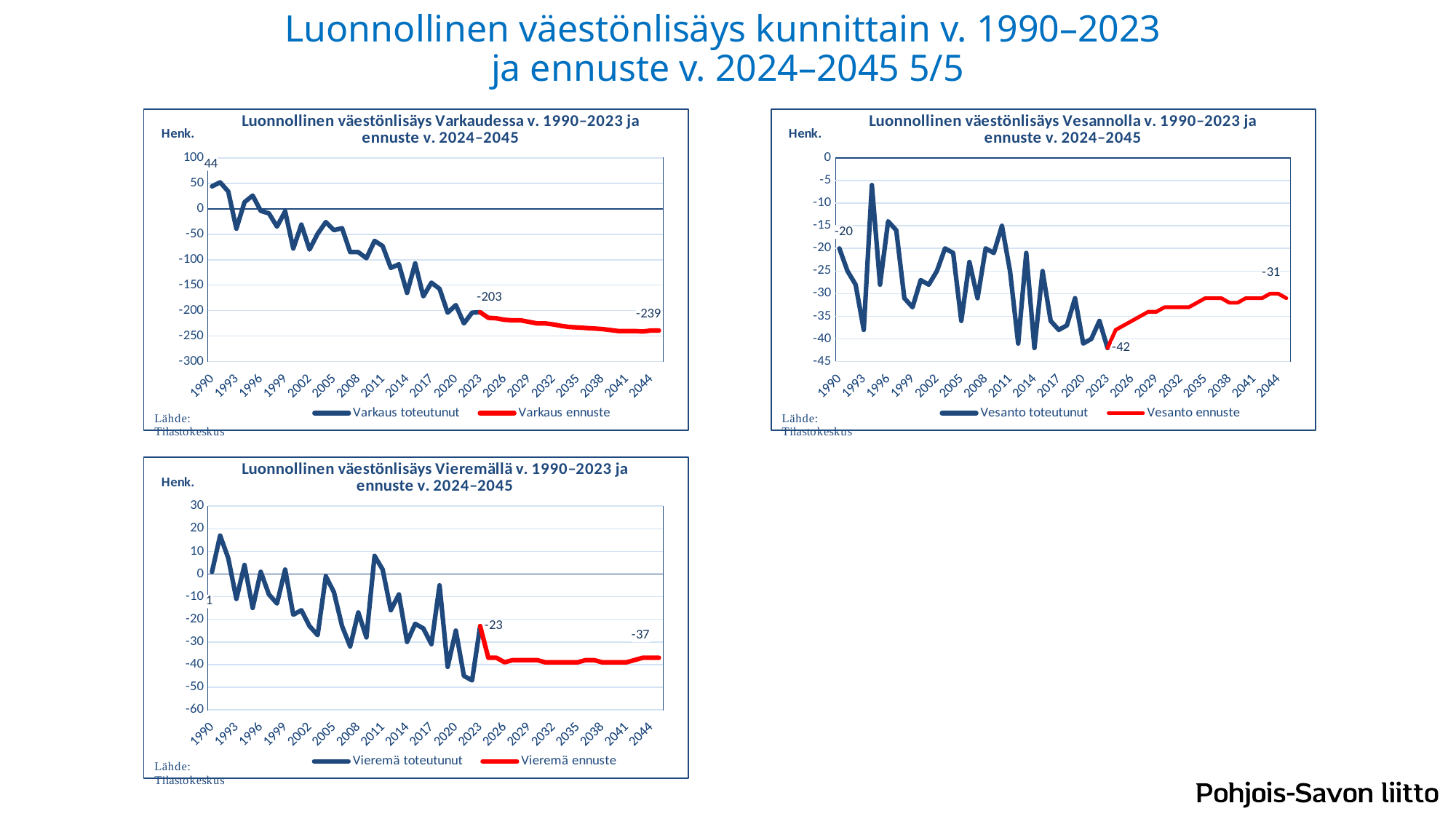
How many series does the legend of the Vieremä chart list? 2 In the Vesanto chart, is the 2045 forecast value larger or smaller than the 2023 value? larger In the Vieremä chart, what is the difference between the 2023 value (-23) and the 2045 value (-37)? 14 In the Vesanto chart, what is the labelled value for 2045? -31 In the Vieremä chart, what is the labelled value for 2045? -37 In the Varkaus chart, what is the labelled value at the end of the forecast in 2045? -239 In the Varkaus chart, what is the labelled value for 1990? 44 What kind of chart is the Varkaus chart? line chart In the Varkaus chart, does the forecast line (2024–2045) rise or fall over time? fall In the Vesanto chart, what is the labelled value for 2023? -42 In the Vesanto chart, what colour is the forecast (ennuste) line? red In the Varkaus chart, what is the labelled value for 2023? -203